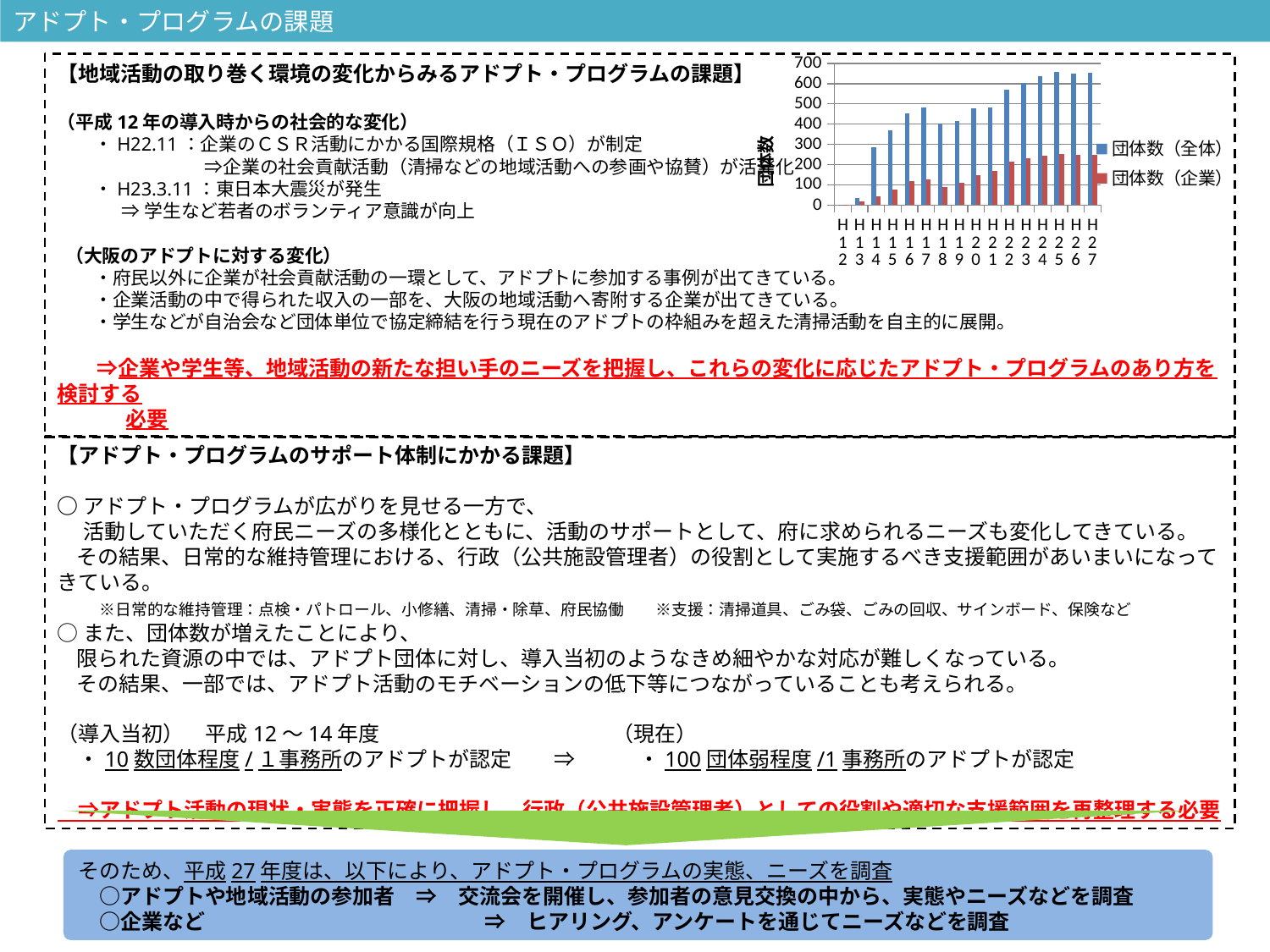
What kind of chart is shown on the slide? bar chart Which is larger: 団体数（全体） in H21 or 団体数（全体） in H13? H21 Overall, do the values for 団体数（全体） rise or fall from H12 to H27? rise Is the value for 団体数（全体） in H22 greater or less than 500? greater Is the value for 団体数（全体） in H12 greater or less than 100? less How many years (categories) are shown along the x axis of the chart? 16 What is the label on the chart's vertical axis? 団体数 Which year has the lowest value for 団体数（全体）? H12 Which year has the lowest value for 団体数（企業）? H12 How many series does the chart's legend list? 2 Is the value for 団体数（企業） in H27 greater or less than 200? greater What are the two series named in the chart's legend? 団体数（全体） and 団体数（企業）